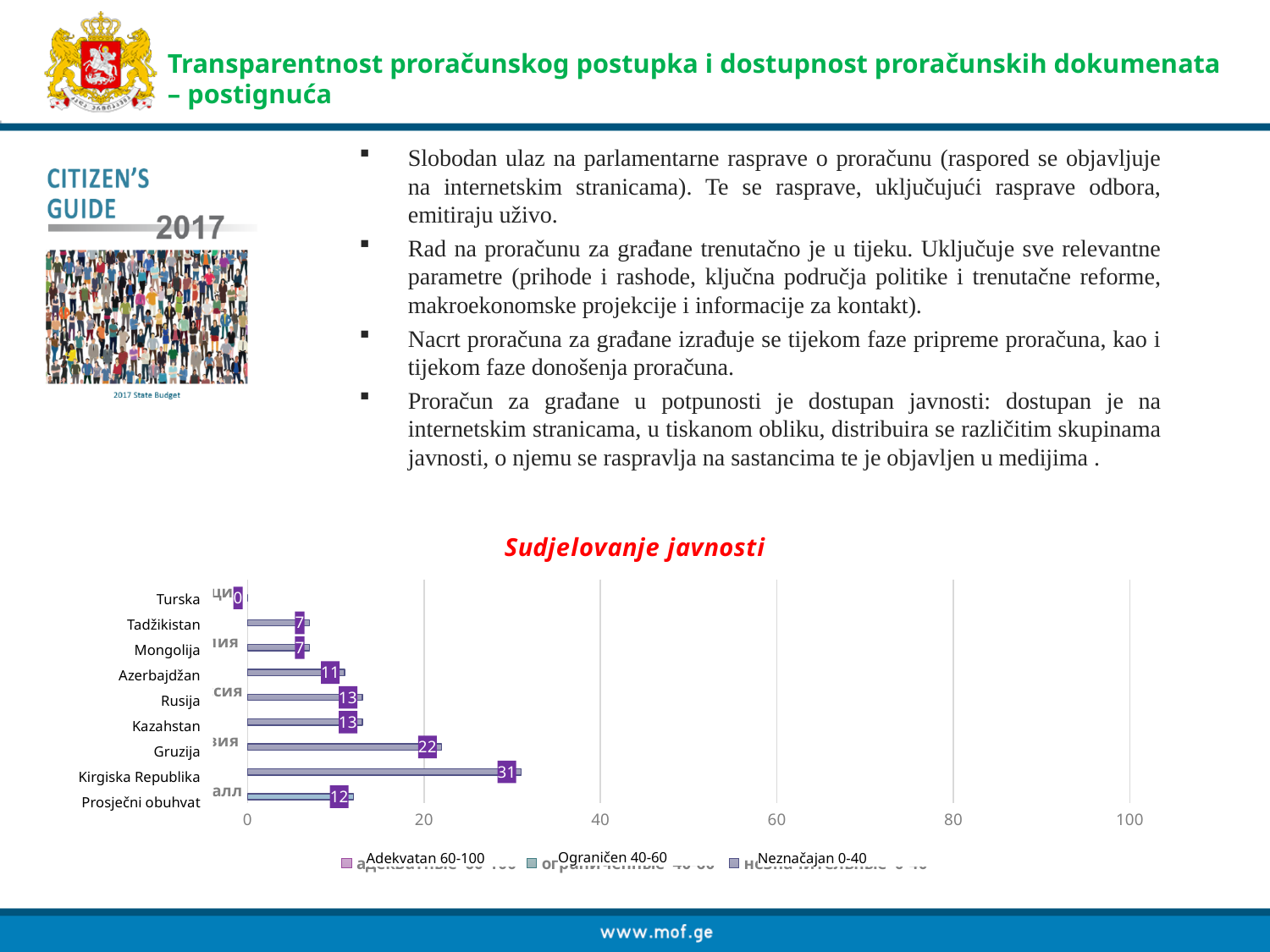
What is the value for Prosječni obuhvat in the Sudjelovanje javnosti chart? 12 What is the value for Kirgiska Republika in the Sudjelovanje javnosti chart? 31 Which category has the highest value in the Sudjelovanje javnosti chart? Kirgiska Republika Which category has the lowest value in the Sudjelovanje javnosti chart? Turska How many entries does the legend of the Sudjelovanje javnosti chart list? 3 How many categories are shown in the Sudjelovanje javnosti chart? 9 Which has a larger value in the Sudjelovanje javnosti chart, Rusija or Tadžikistan? Rusija What is the value for Azerbajdžan in the Sudjelovanje javnosti chart? 11 What is the value for Gruzija in the Sudjelovanje javnosti chart? 22 Is the value for Kirgiska Republika in the Sudjelovanje javnosti chart greater or less than 40? less What is the difference between the values for Kirgiska Republika and Gruzija in the Sudjelovanje javnosti chart? 9 What type of chart is the Sudjelovanje javnosti chart? bar chart